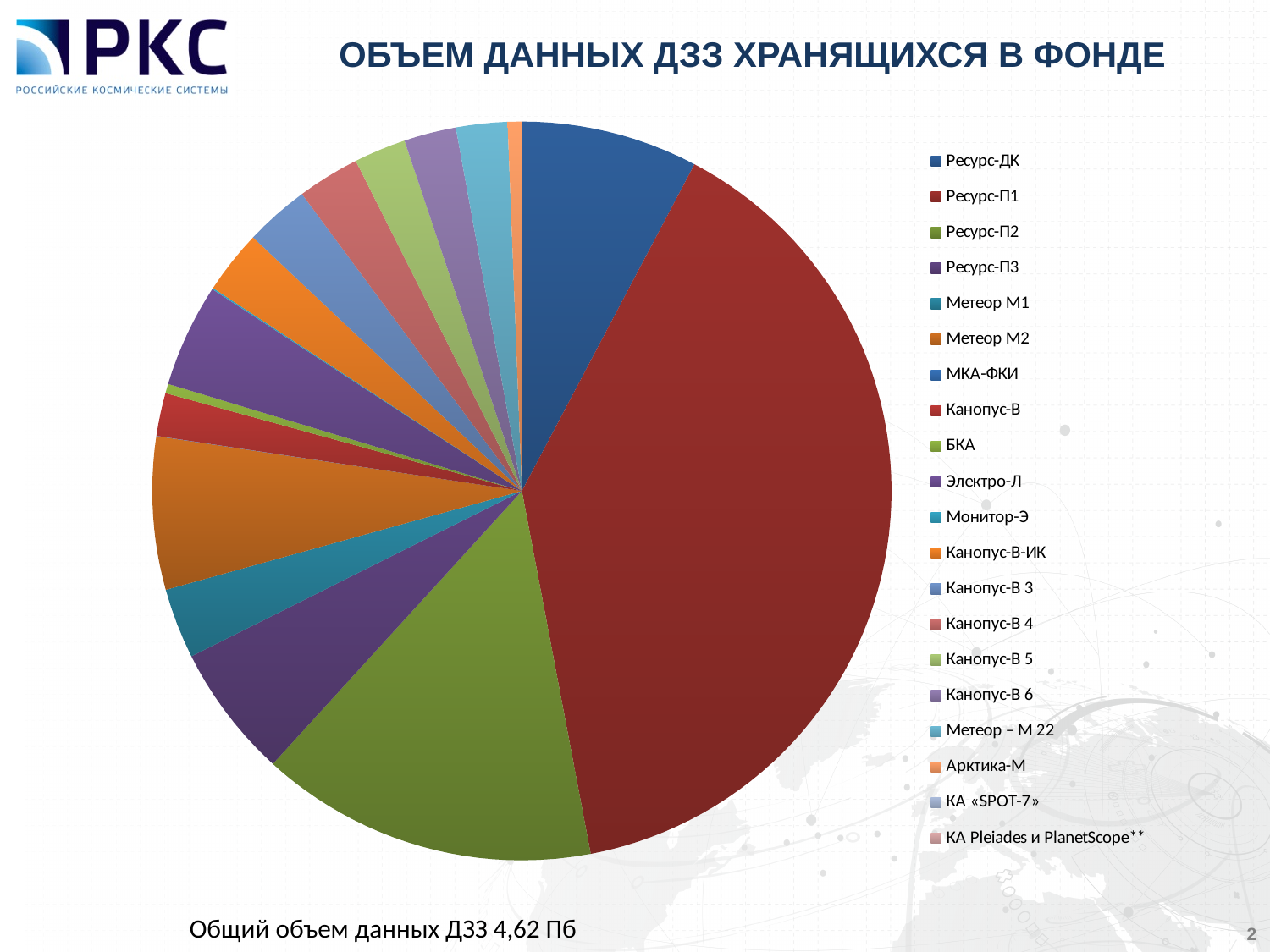
What total volume of remote sensing data is stated below the chart? 4,62 Пб What kind of chart is shown on the slide? pie chart Which slice is larger, Ресурс-ДК or Канопус-В? Ресурс-ДК Does the Ресурс-П1 slice account for more or less than half of the pie? less What is the title of the chart on the slide? ОБЪЕМ ДАННЫХ ДЗЗ ХРАНЯЩИХСЯ В ФОНДЕ How many entries does the chart legend list? 20 Which slice is larger, Ресурс-П1 or Ресурс-ДК? Ресурс-П1 Which slice is larger, Ресурс-П2 or Ресурс-П3? Ресурс-П2 Which category has the largest slice of the pie? Ресурс-П1